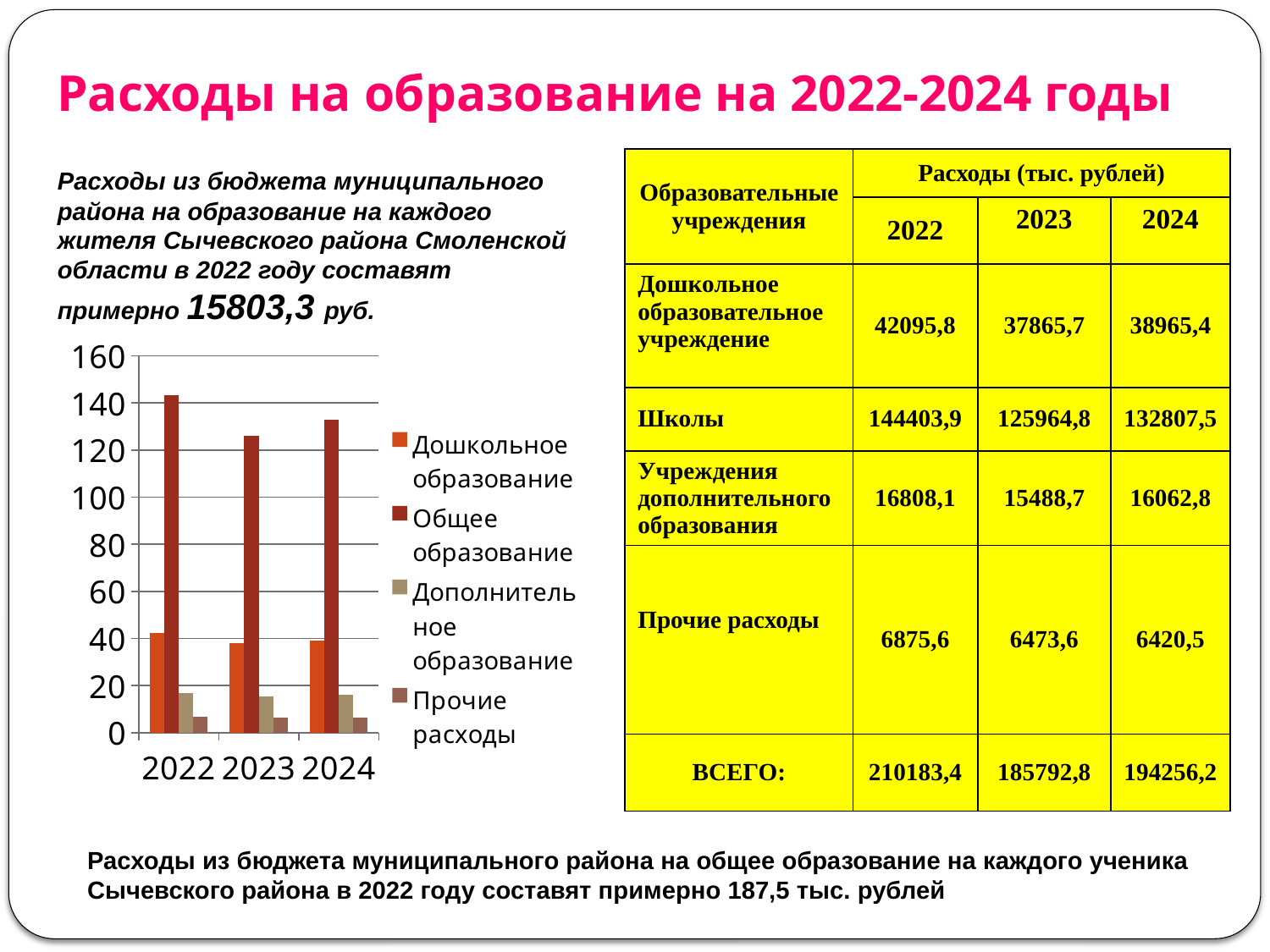
Is the value for Общее образование in 2023 greater or less than 140? less Which is larger: Общее образование in 2022 or Общее образование in 2023? 2022 Is the value for Общее образование in 2024 greater or less than 120? greater Which series has the tallest bar in 2022? Общее образование Is the value for Дополнительное образование in 2022 greater or less than 20? less How many years (categories) are shown on the x axis of the chart? 3 How many series does the chart legend list? 4 Which legend entry is shown in the lightest (tan) colour? Дополнительное образование What kind of chart is shown on the slide? bar chart Which series has the shortest bar in 2024? Прочие расходы Does the value for Общее образование rise or fall from 2022 to 2023? fall